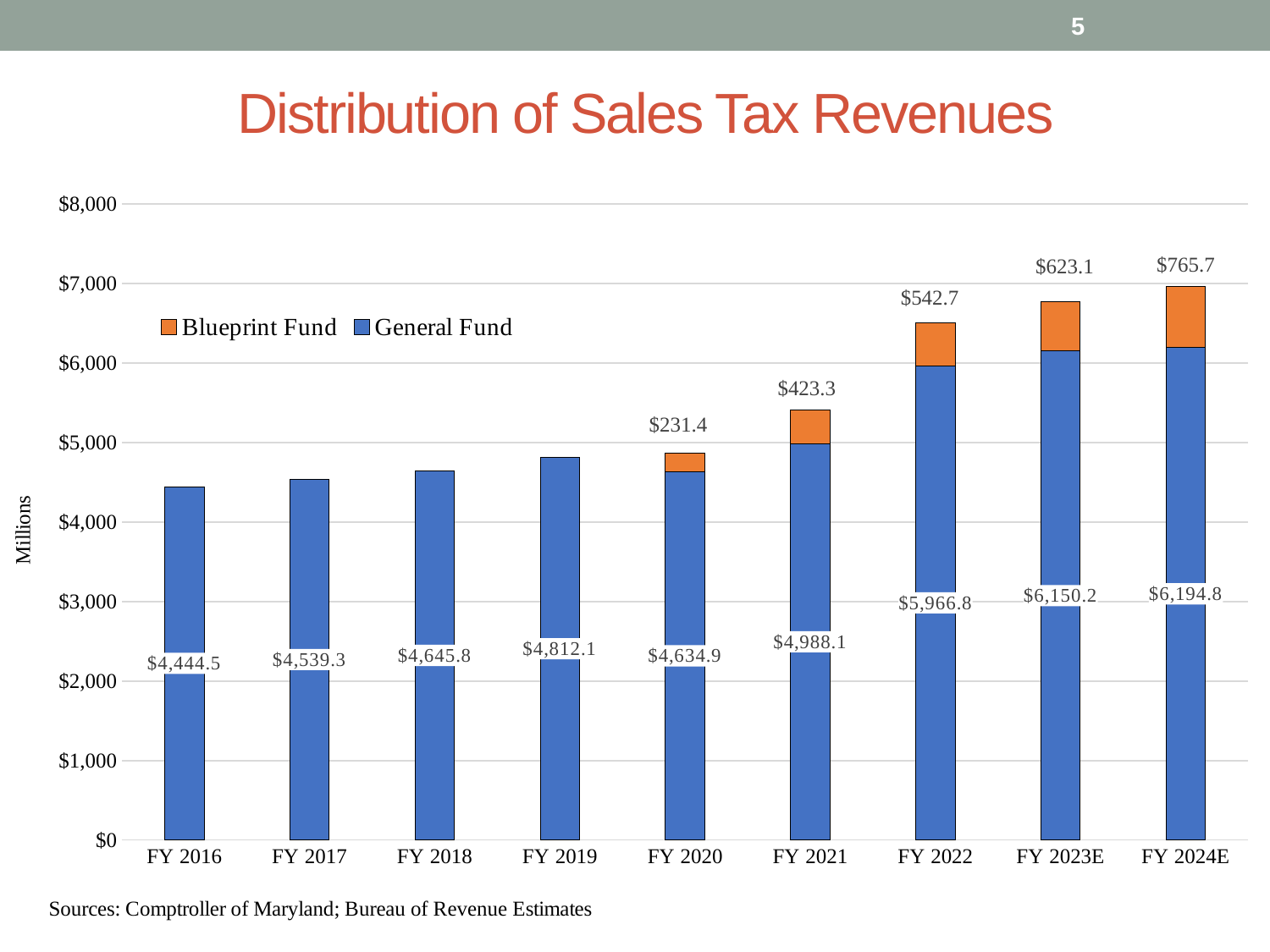
What is the General Fund value for FY 2023E? $6,150.2 What is the difference between the Blueprint Fund values for FY 2024E and FY 2020? $534.3 What is the total of the stacked bar for FY 2022? $6,509.5 What is the Blueprint Fund value for FY 2021? $423.3 Which is larger, the General Fund value for FY 2019 or for FY 2020? FY 2019 Which fiscal year has the lowest General Fund value? FY 2016 What kind of chart is shown on the slide? Stacked bar chart What is the General Fund value for FY 2016? $4,444.5 How many series does the legend list? 2 What is the total of the stacked bar for FY 2024E? $6,960.5 How many fiscal years are shown on the x axis? 9 Which fiscal year has the highest General Fund value? FY 2024E